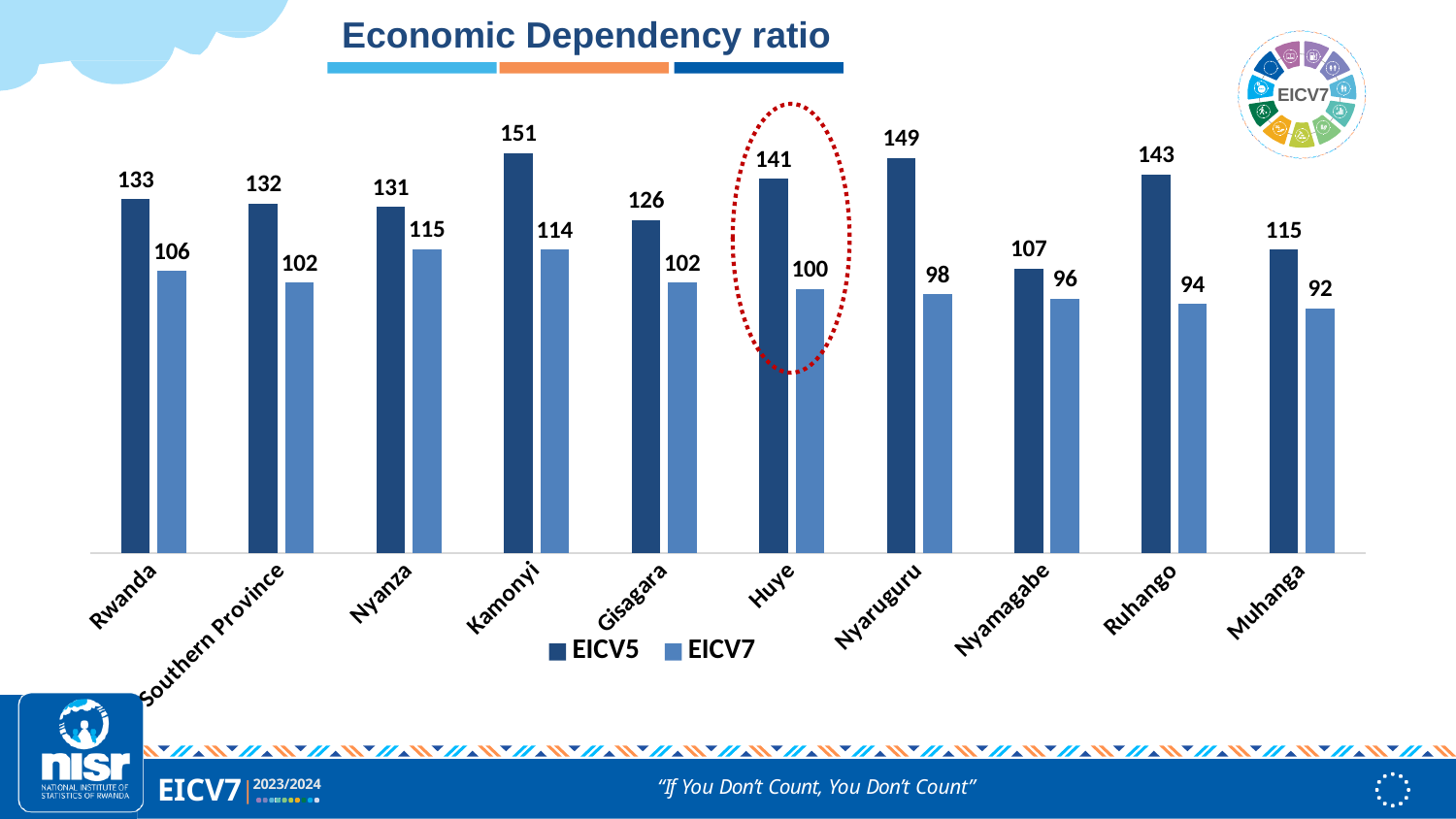
What is the EICV7 value for Rwanda? 106 What is the EICV7 economic dependency ratio for Huye? 100 How many series does the legend list? 2 What is the EICV5 economic dependency ratio for Kamonyi? 151 Which category has the highest EICV5 value? Kamonyi How many categories are shown on the x axis? 10 What kind of chart is shown on the slide? Bar chart Which is larger, the EICV7 value for Nyanza or the EICV7 value for Ruhango? Nyanza What is the difference between the EICV5 and EICV7 values for Nyaruguru? 51 Which category has the lowest EICV7 value? Muhanga What is the title of the chart? Economic Dependency ratio Which category is highlighted with a red dotted circle? Huye